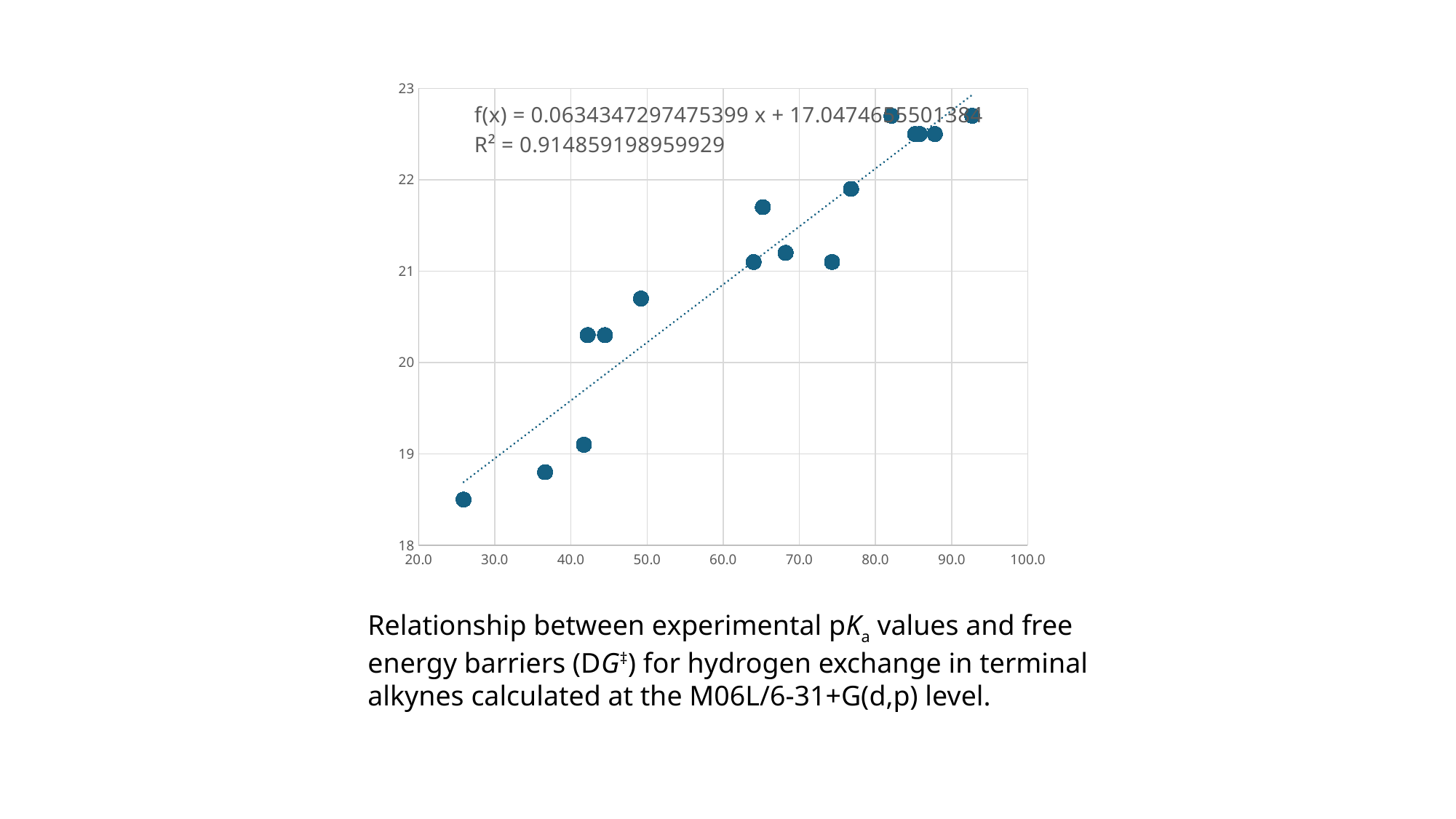
Is the y-value of the leftmost data point (near x = 26) greater or less than 19? less Is the y-value of the rightmost data point (near x = 93) greater or less than 22? greater What R² value is printed on the chart? 0.914859198959929 Which data point has the lowest y-value: the one near x = 26 or the one near x = 37? the one near x = 26 What is the slope of the fitted line f(x) printed on the chart? 0.0634347297475399 What kind of chart is shown on the slide? scatter chart Is the y-value of the data point near x = 49 greater or less than 21? less Do the plotted values generally rise or fall as the x-axis value increases? rise What is the maximum value shown on the x-axis? 100.0 Which data point has the larger y-value: the one near x = 65 or the one near x = 74? the one near x = 65